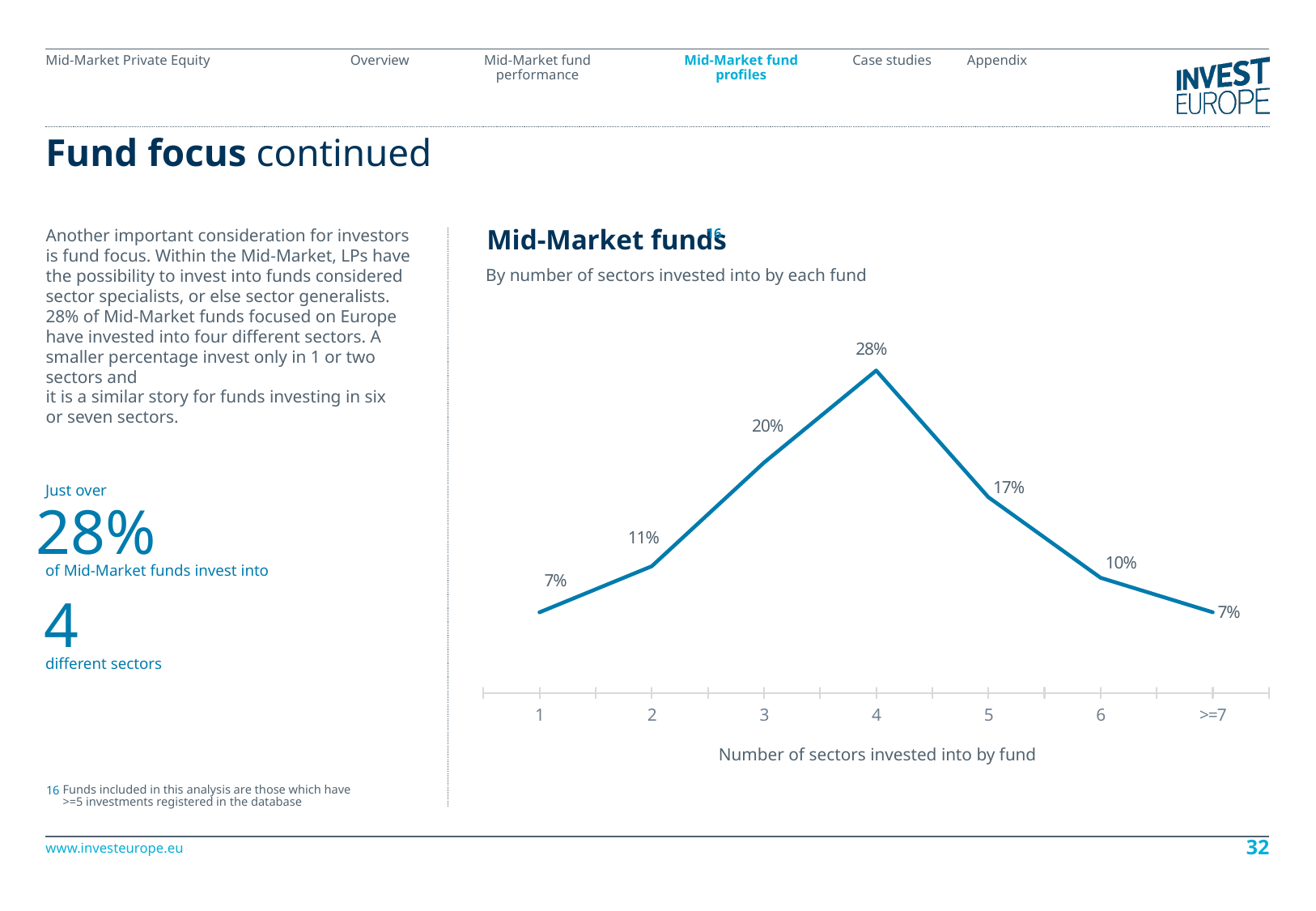
What kind of chart is shown? Line chart Which is larger: the percentage for 3 sectors or the percentage for 5 sectors? 3 sectors What is the x-axis label of the chart? Number of sectors invested into by fund What percentage of Mid-Market funds invested into 2 sectors? 11% What percentage of Mid-Market funds invested into 4 sectors? 28% Do the values rise or fall from 4 sectors to >=7 sectors? Fall What percentage of Mid-Market funds invested into 6 sectors? 10% What is the difference in percentage points between funds investing in 5 sectors and funds investing in 6 sectors? 7 Which number of sectors has the highest percentage of funds? 4 What percentage of Mid-Market funds invested into 5 sectors? 17% What is the difference in percentage points between funds investing in 4 sectors and funds investing in 3 sectors? 8 How many categories are shown on the x axis? 7